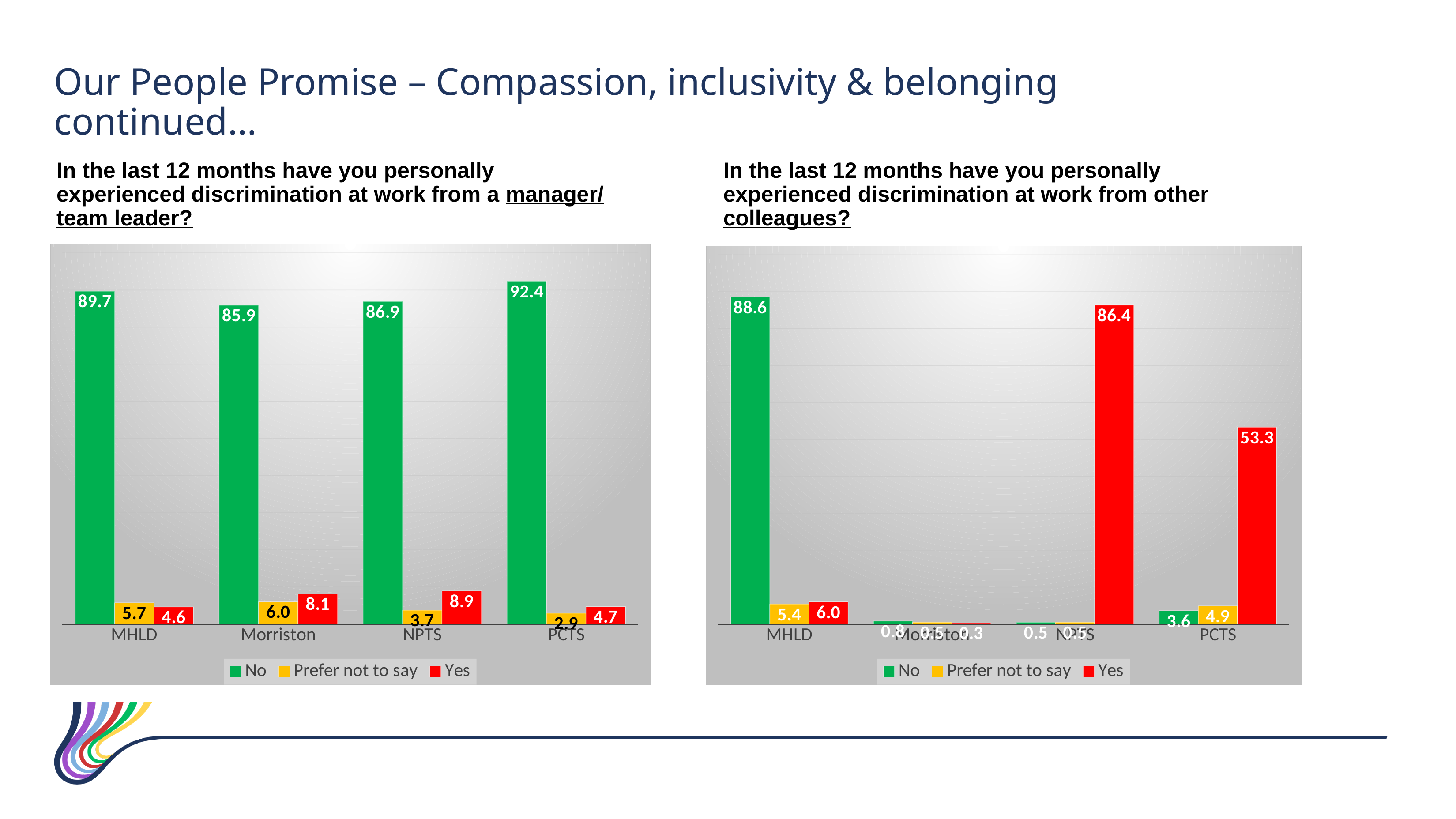
On the left chart (discrimination from a manager/team leader), what is the difference between the 'No' values for PCTS and Morriston? 6.5 On the right chart (discrimination from other colleagues), what is the 'No' value for MHLD? 88.6 On the left chart (discrimination from a manager/team leader), what is the 'No' value for PCTS? 92.4 On the left chart (discrimination from a manager/team leader), what is the 'Yes' value for NPTS? 8.9 On the right chart (discrimination from other colleagues), what is the 'Yes' value for NPTS? 86.4 On the right chart (discrimination from other colleagues), what is the 'Yes' value for PCTS? 53.3 On the left chart (discrimination from a manager/team leader), which category has the lowest 'Prefer not to say' value? PCTS How many series does the legend of the right chart (discrimination from other colleagues) list? 3 On the left chart (discrimination from a manager/team leader), what is the 'Prefer not to say' value for Morriston? 6.0 What type of chart is the left chart (discrimination from a manager/team leader)? Bar chart On the left chart (discrimination from a manager/team leader), is the 'Yes' value larger for Morriston or for MHLD? Morriston On the left chart (discrimination from a manager/team leader), which category has the highest 'No' value? PCTS